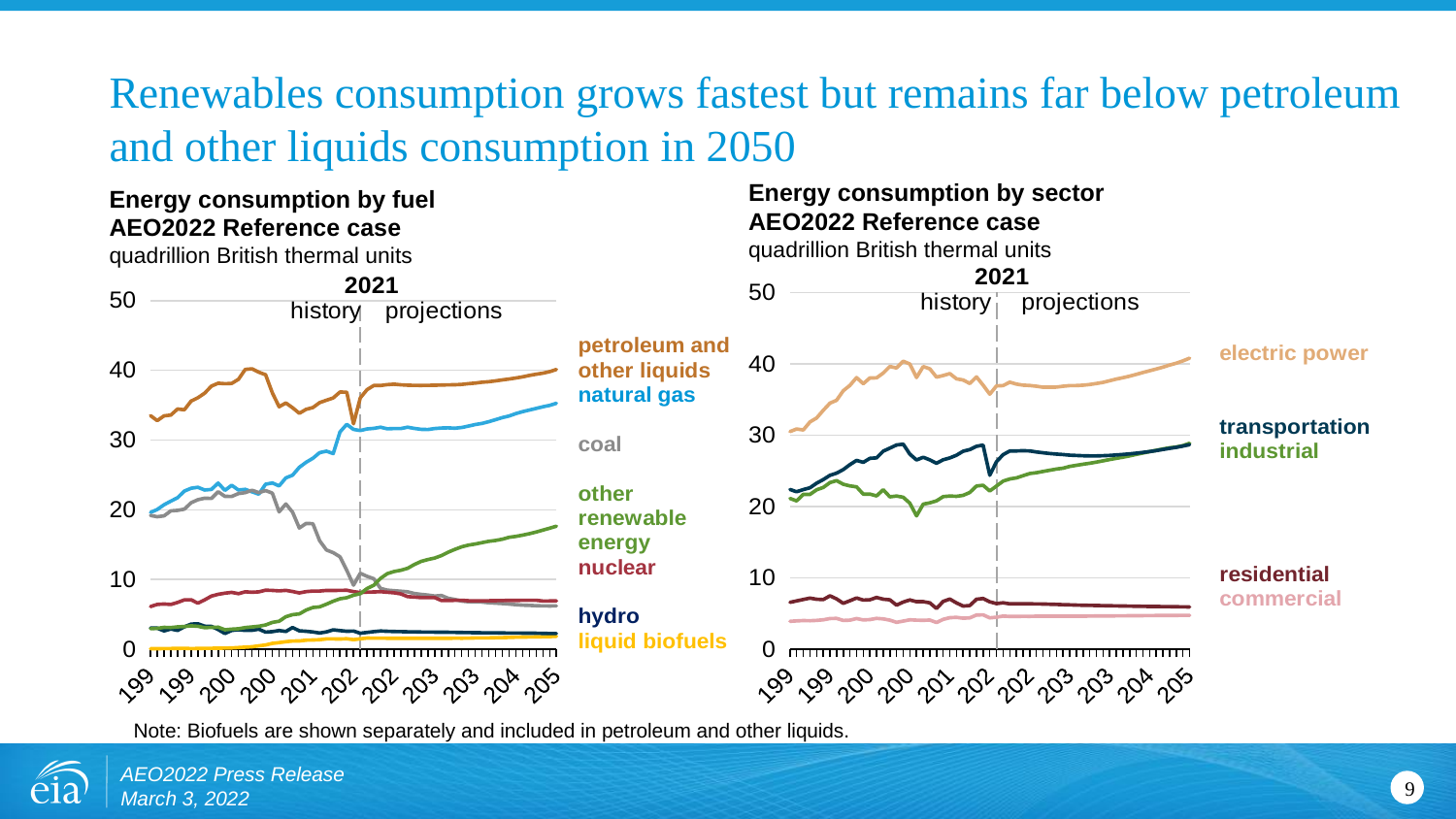
On the 'Energy consumption by fuel' chart, which fuel has the highest consumption at the end of the projection period? petroleum and other liquids On the 'Energy consumption by sector' chart, which sector has the lowest consumption at the end of the projection period? commercial On the 'Energy consumption by fuel' chart, which fuel has the lowest consumption at the end of the projection period? liquid biofuels How many fuel series are labelled on the 'Energy consumption by fuel' chart? 7 How many sector series are labelled on the 'Energy consumption by sector' chart? 5 On the 'Energy consumption by fuel' chart, is the value for natural gas at the end of the projection period greater or less than 30? greater On the 'Energy consumption by fuel' chart, does other renewable energy consumption rise or fall over the projection period? rise On the 'Energy consumption by fuel' chart, is the value for coal at the end of the projection period greater or less than 10? less On the 'Energy consumption by sector' chart, which is larger at the end of the projection period, electric power or transportation? electric power What year does the dashed vertical line separating history from projections mark on both charts? 2021 What type of chart is the 'Energy consumption by fuel' chart on the left? line chart On the 'Energy consumption by sector' chart, which sector has the highest consumption at the end of the projection period? electric power